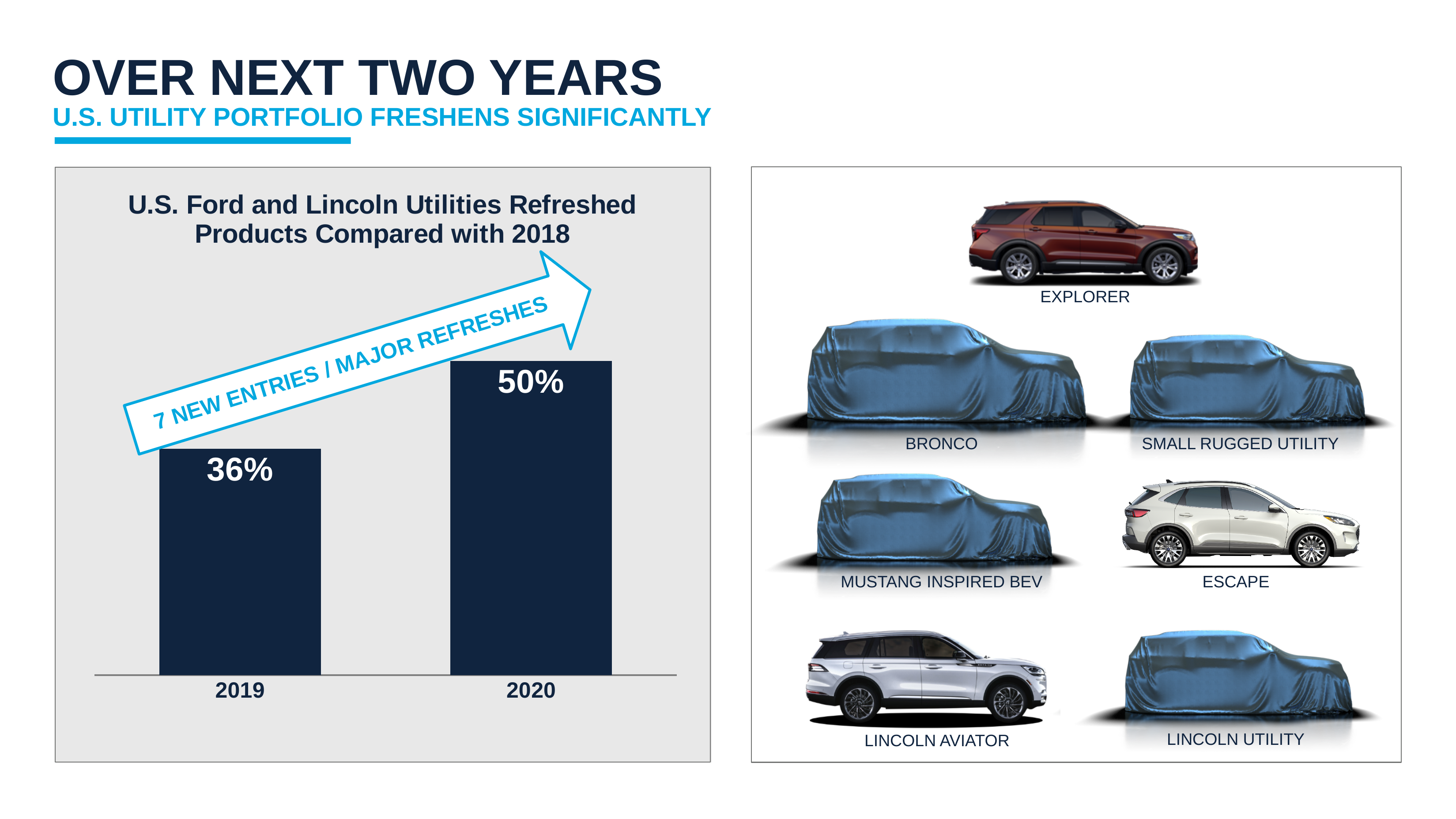
What is the difference between the 2020 and 2019 values? 14% What text is written on the arrow overlaid on the chart? 7 NEW ENTRIES / MAJOR REFRESHES What is the value for 2020? 50% Do the values rise or fall from 2019 to 2020? Rise Is the value for 2020 larger than the value for 2019? Yes What kind of chart is shown on the slide? Bar chart What is the value for 2019? 36% How many bars are shown in the chart? 2 What is the title of the chart? U.S. Ford and Lincoln Utilities Refreshed Products Compared with 2018 Which year has the higher value? 2020 Which year has the lower value? 2019